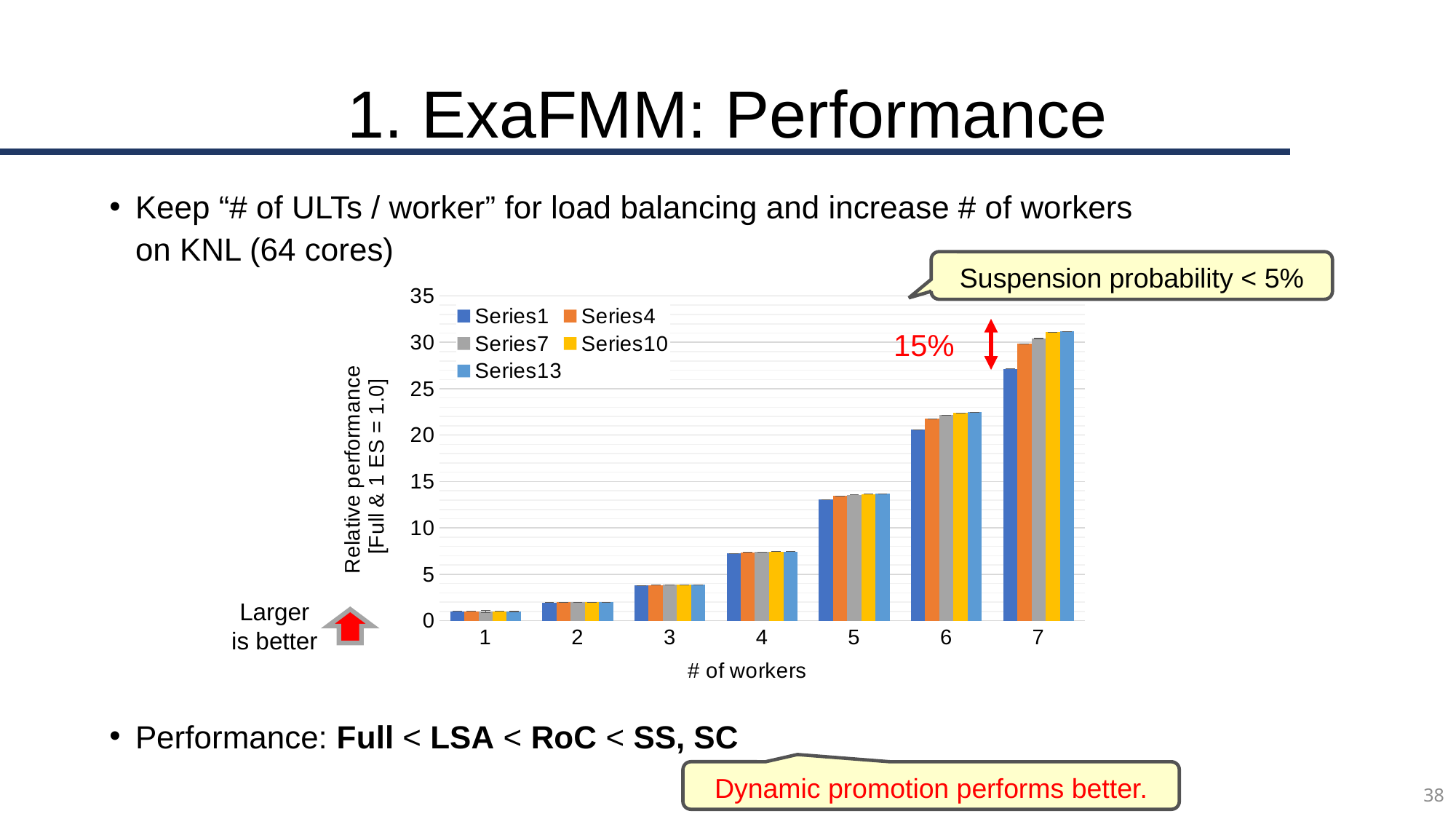
How many categories (# of workers values) are shown on the x axis? 7 Is the value for Series13 at 6 workers greater or less than 20? greater Is the value for Series1 at 7 workers greater or less than 25? greater How many series does the chart legend list? 5 What is the name of the last series listed in the legend? Series13 Is the value for Series1 at 4 workers greater or less than 10? less At which number of workers is the relative performance highest? 7 At which number of workers is the relative performance lowest? 1 What is the title of the x axis? # of workers What kind of chart is shown on the slide? bar chart At 7 workers, which is larger: Series1 or Series13? Series13 Do the relative performance values rise or fall as the number of workers increases? rise